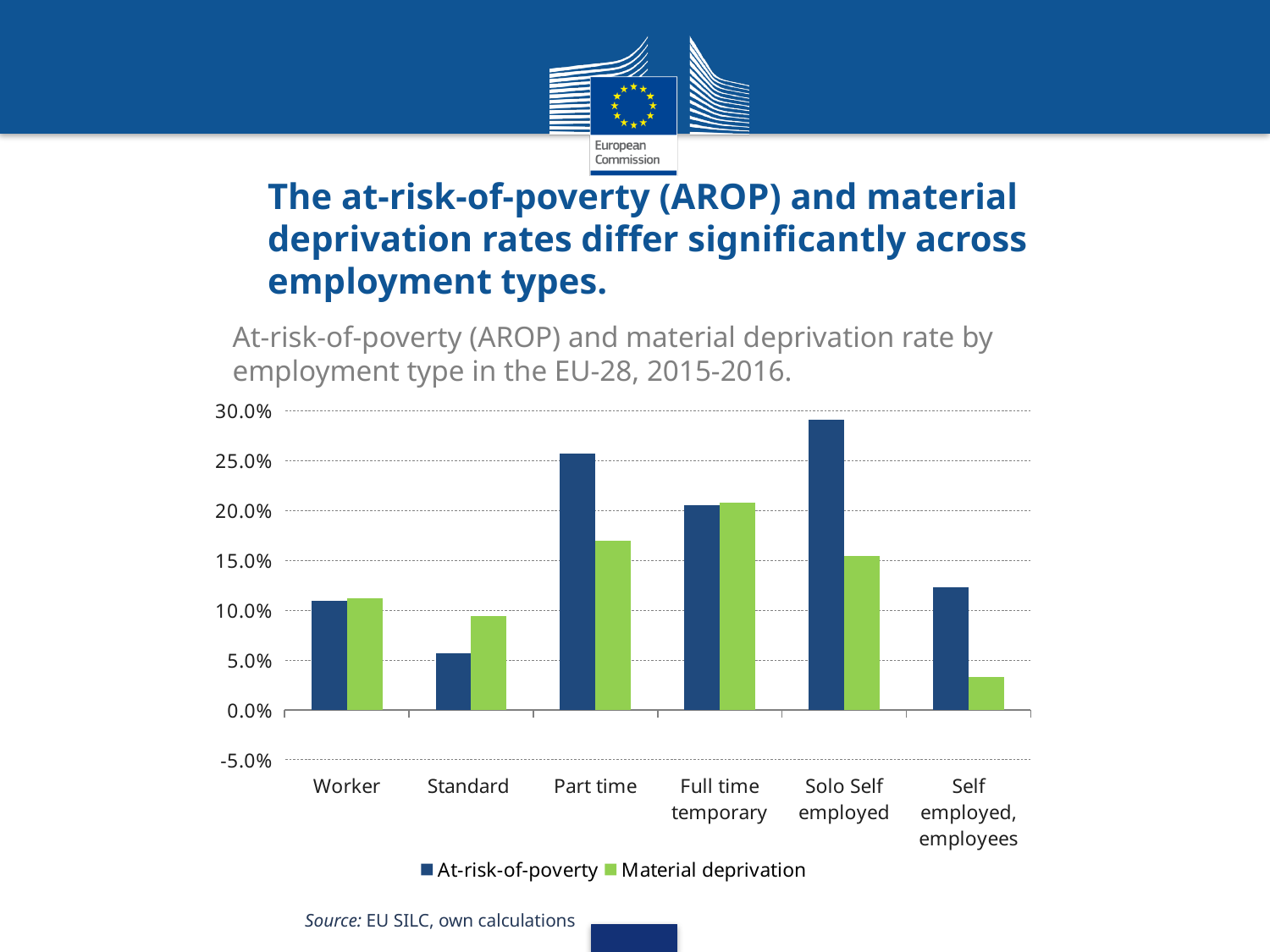
What is the subtitle of the chart on the slide? At-risk-of-poverty (AROP) and material deprivation rate by employment type in the EU-28, 2015-2016. Which employment type has the highest material deprivation rate? Full time temporary How many employment types are shown on the x axis of the chart? 6 For Part time workers, which is larger: the at-risk-of-poverty rate or the material deprivation rate? At-risk-of-poverty How many series does the chart's legend list? 2 For Standard workers, which is larger: the at-risk-of-poverty rate or the material deprivation rate? Material deprivation Is the at-risk-of-poverty rate for Solo Self employed greater or less than 25.0%? greater Which employment type has the lowest at-risk-of-poverty rate? Standard Which employment type has the highest at-risk-of-poverty rate? Solo Self employed Which employment type has the lowest material deprivation rate? Self employed, employees What type of chart is shown on the slide? bar chart Is the material deprivation rate for Self employed, employees greater or less than 5.0%? less